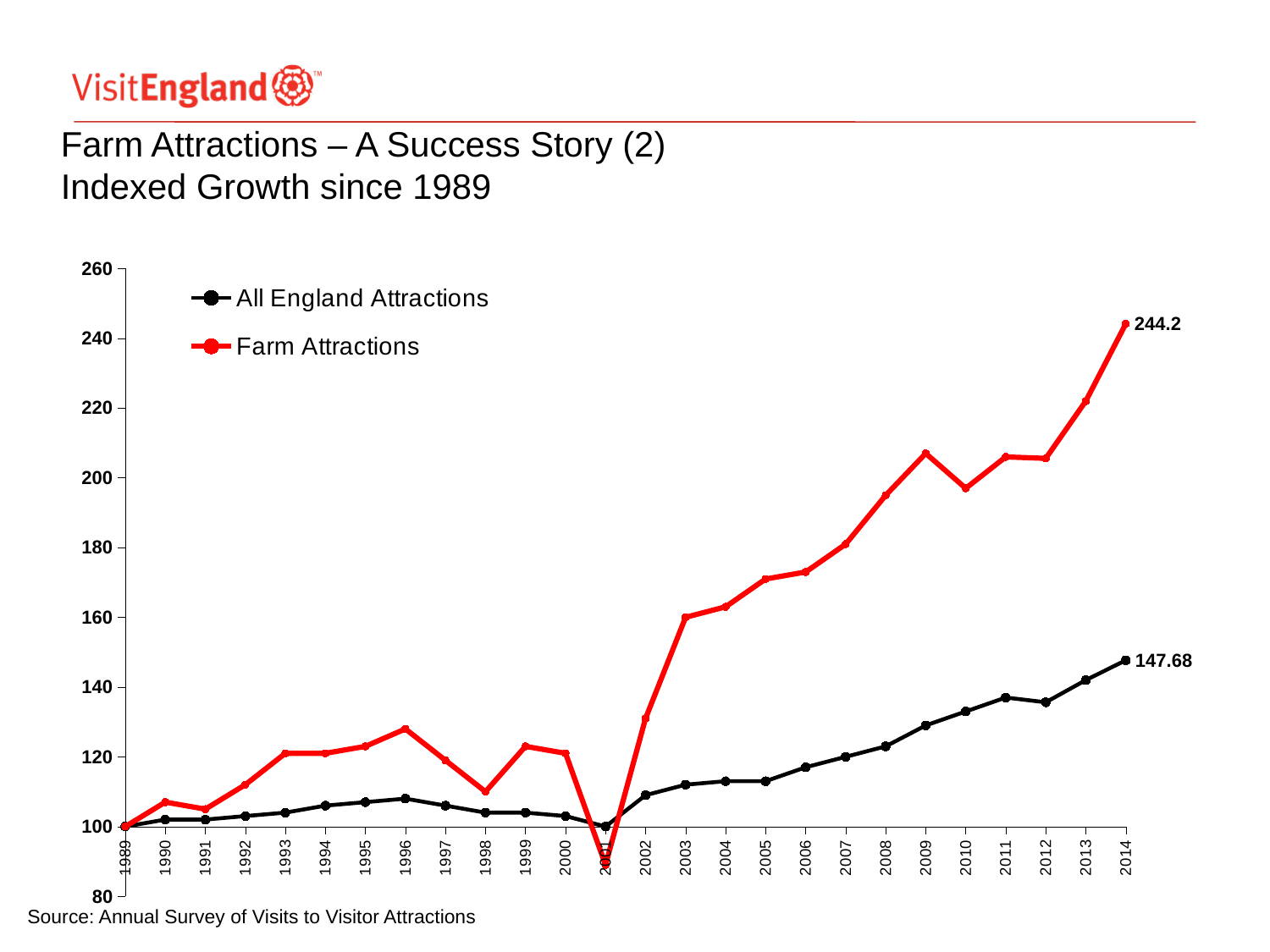
In which year does the Farm Attractions series reach its highest value? 2014 How many series does the legend list? 2 In 2014, which series has the larger value, Farm Attractions or All England Attractions? Farm Attractions Is the value for Farm Attractions in 2009 greater or less than 200? greater How many years are shown on the x axis? 26 What kind of chart is shown on the slide? Line chart Is the value for Farm Attractions in 2001 greater or less than 100? less What is the difference between the Farm Attractions and All England Attractions values in 2014? 96.52 What is the value for Farm Attractions in 2014? 244.2 What is the value for All England Attractions in 2014? 147.68 Is the value for All England Attractions in 2010 greater or less than 140? less In which year does the Farm Attractions series reach its lowest value? 2001